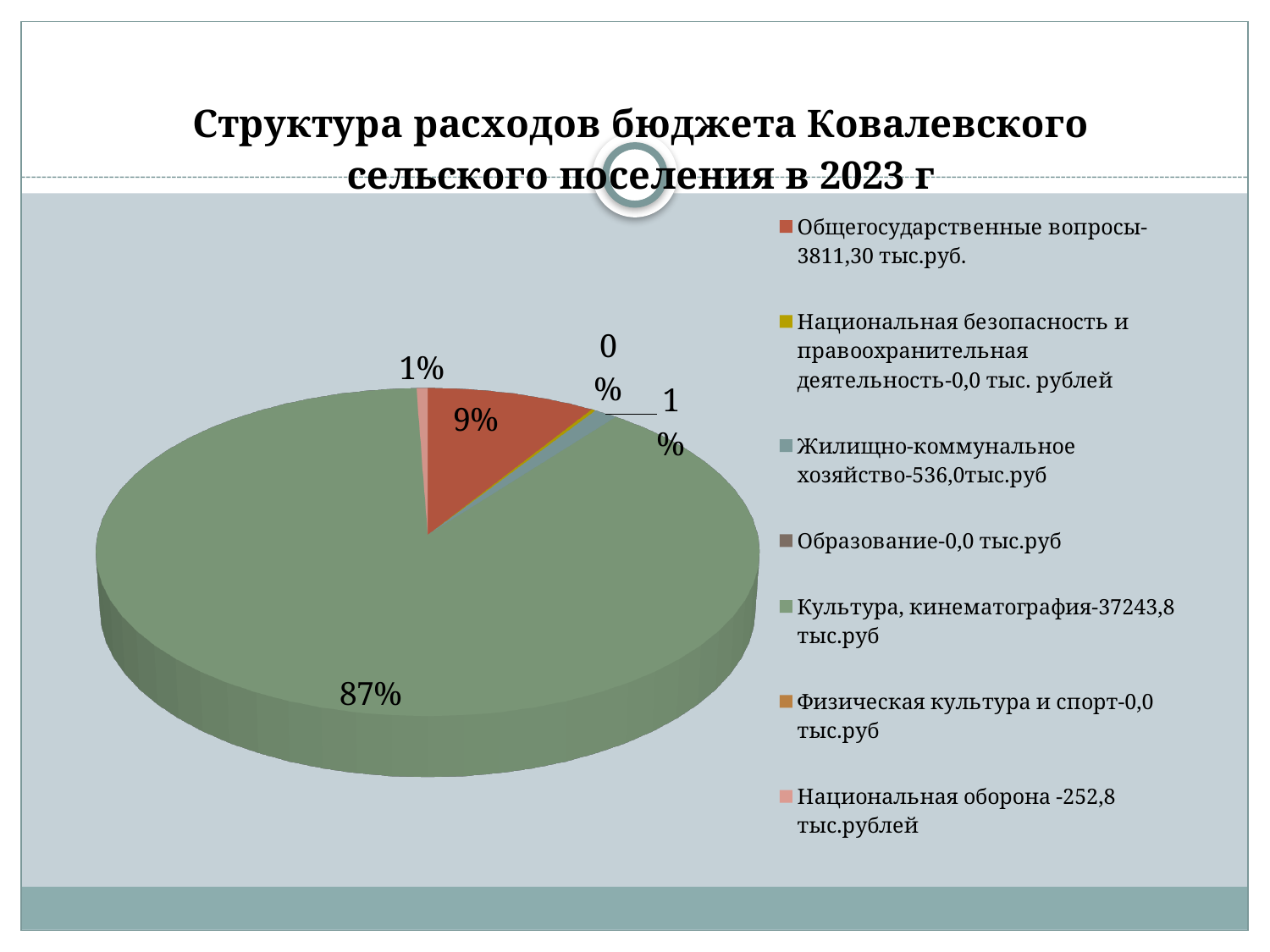
Which slice is larger: Общегосударственные вопросы or Национальная оборона? Общегосударственные вопросы What colour is the Культура, кинематография slice in the pie chart? green According to the legend, what amount in тыс.руб is given for Жилищно-коммунальное хозяйство? 536,0 тыс.руб What share of the pie does Национальная оборона take? 1% What is the difference in percentage points between the Культура, кинематография slice and the Общегосударственные вопросы slice? 78% How many categories does the legend of the pie chart list? 7 What share of the pie does Общегосударственные вопросы take? 9% What share of the pie does Культура, кинематография take? 87% What is the title of the chart on the slide? Структура расходов бюджета Ковалевского сельского поселения в 2023 г According to the legend, what amount is given for Культура, кинематография? 37243,8 тыс.руб What kind of chart is shown on the slide? pie chart Which category has the largest slice of the pie? Культура, кинематография